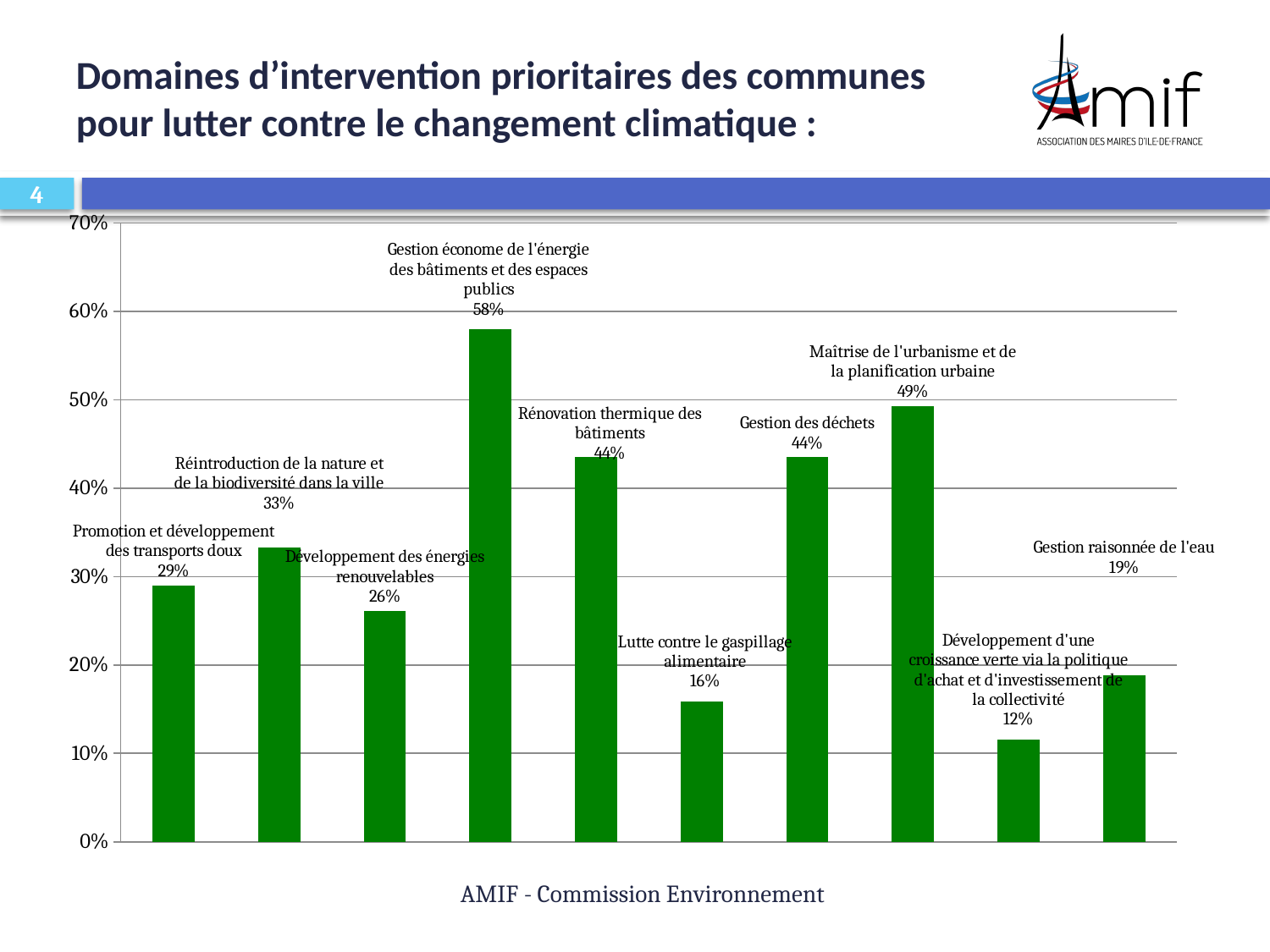
What is the value for "Gestion économe de l'énergie des bâtiments et des espaces publics"? 58% What is the difference between "Maîtrise de l'urbanisme et de la planification urbaine" and "Réintroduction de la nature et de la biodiversité dans la ville"? 16% Which category has the lowest value? Développement d'une croissance verte via la politique d'achat et d'investissement de la collectivité What is the value for "Lutte contre le gaspillage alimentaire"? 16% What colour are the bars in the chart? Green Is the value for "Gestion des déchets" greater or less than 40%? greater Which is larger: "Promotion et développement des transports doux" or "Développement des énergies renouvelables"? Promotion et développement des transports doux How many categories are shown in the chart? 10 What kind of chart is shown on the slide? Bar chart Which category has the highest value? Gestion économe de l'énergie des bâtiments et des espaces publics What is the value for "Rénovation thermique des bâtiments"? 44% What is the value for "Gestion raisonnée de l'eau"? 19%